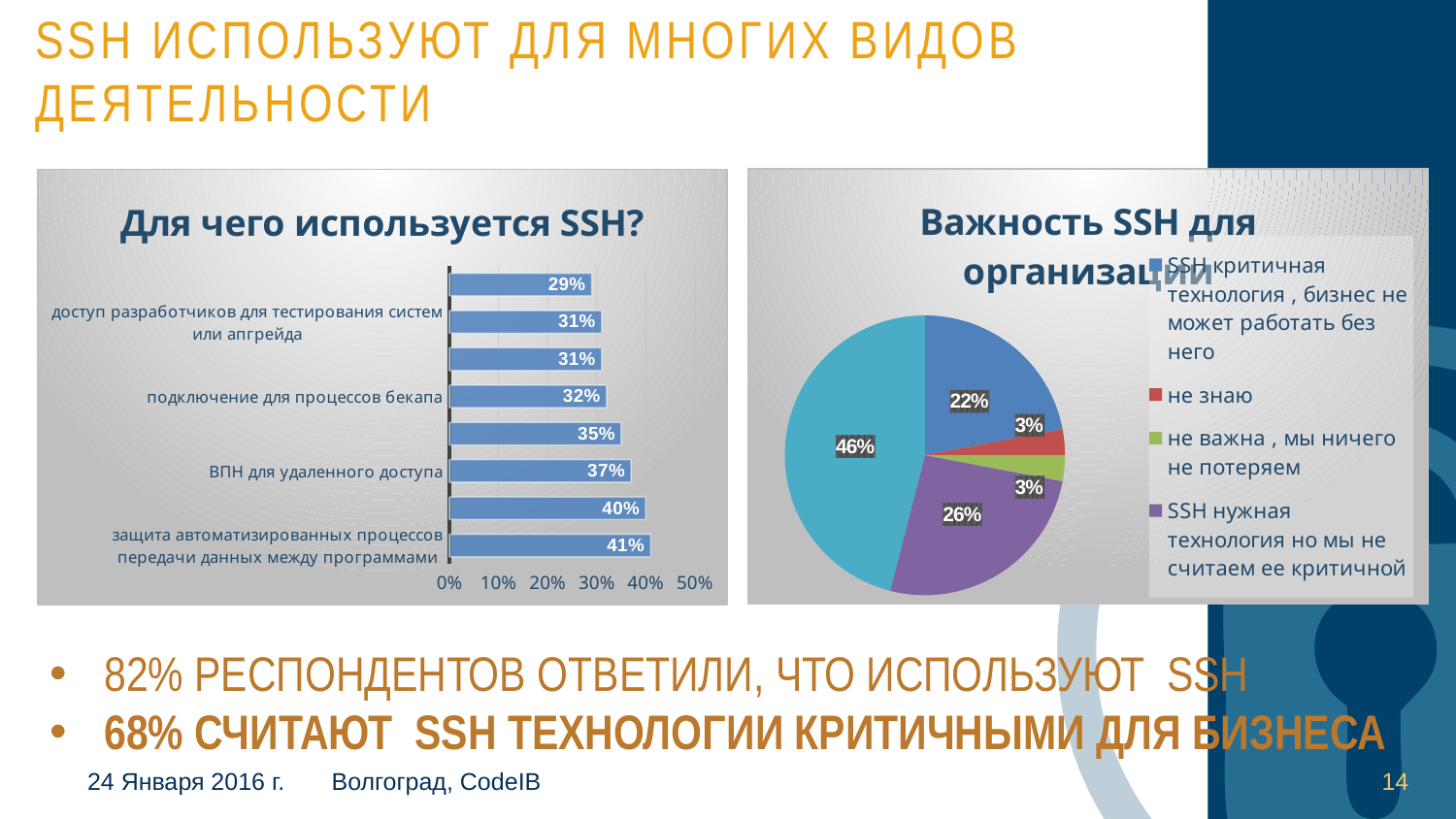
In the bar chart 'Для чего используется SSH?', how many bars are plotted? 8 In the bar chart 'Для чего используется SSH?', what is the value for 'подключение для процессов бекапа'? 32% In the pie chart 'Важность SSH для организации', what share does 'не знаю' have? 3% In the bar chart 'Для чего используется SSH?', what is the value for 'защита автоматизированных процессов передачи данных между программами'? 41% In the pie chart 'Важность SSH для организации', what is the share of the largest slice? 46% In the bar chart 'Для чего используется SSH?', what is the difference between the values for 'ВПН для удаленного доступа' and 'подключение для процессов бекапа'? 5% In the bar chart 'Для чего используется SSH?', what is the highest value shown on any bar? 41% In the pie chart 'Важность SSH для организации', what share does 'SSH нужная технология но мы не считаем ее критичной' have? 26% What kind of chart is 'Для чего используется SSH?'? bar chart In the pie chart 'Важность SSH для организации', how many slices are there? 5 In the bar chart 'Для чего используется SSH?', what is the value for 'ВПН для удаленного доступа'? 37% In the bar chart 'Для чего используется SSH?', what is the lowest value shown on any bar? 29%